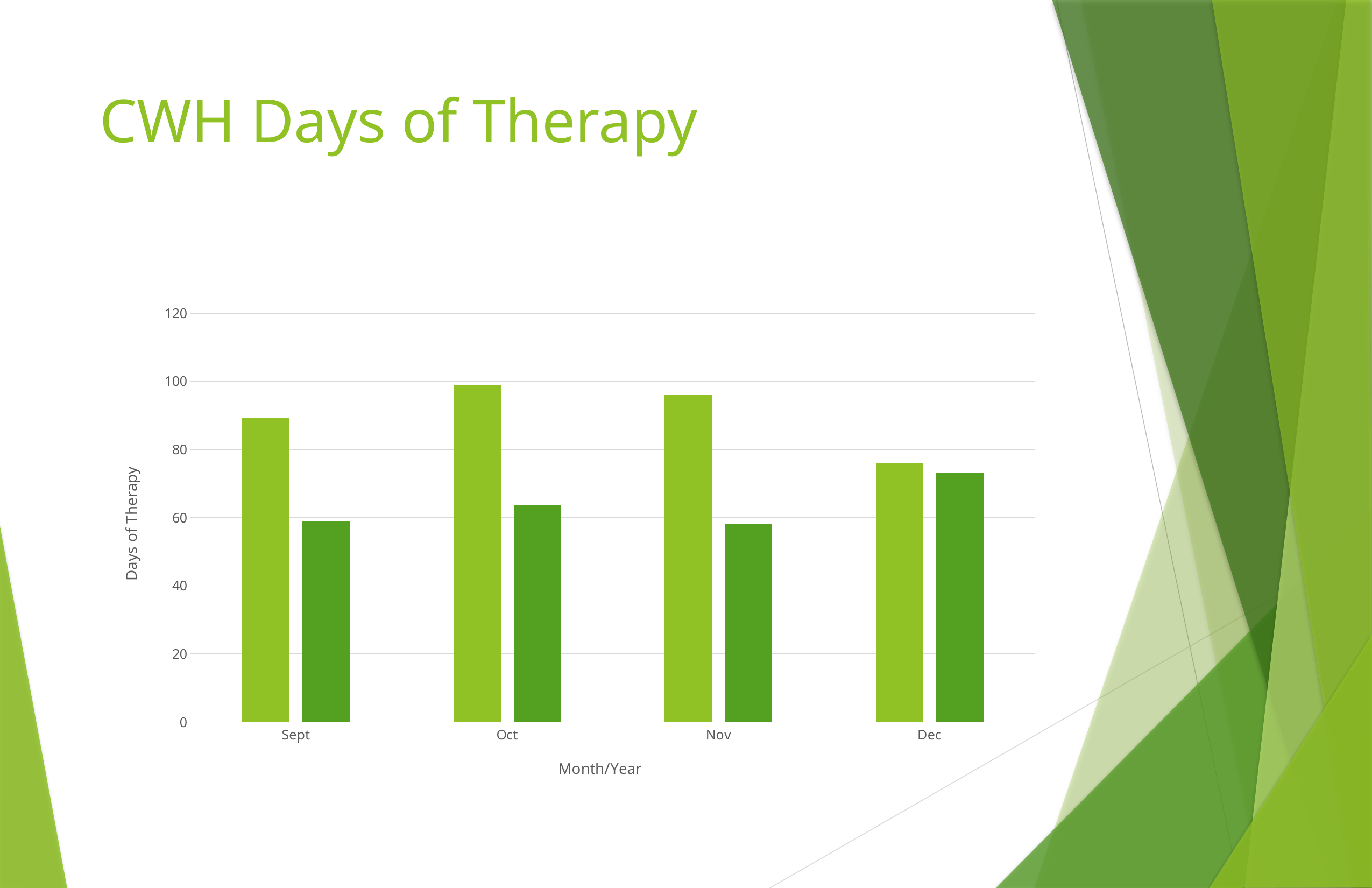
In Nov, which bar is larger, the light green bar or the dark green bar? the light green bar Which month has the lowest light green bar? Dec How many months are shown on the x axis of the chart? 4 Is the light green bar for Oct greater or less than 80? greater How many bars are plotted for each month in the chart? 2 Is the dark green bar for Dec greater or less than 60? greater What is the title of the chart on the slide? CWH Days of Therapy What kind of chart is shown on the slide? bar chart Which month has the highest dark green bar? Dec Is the light green bar for Dec greater or less than 80? less What is the label on the vertical axis of the chart? Days of Therapy